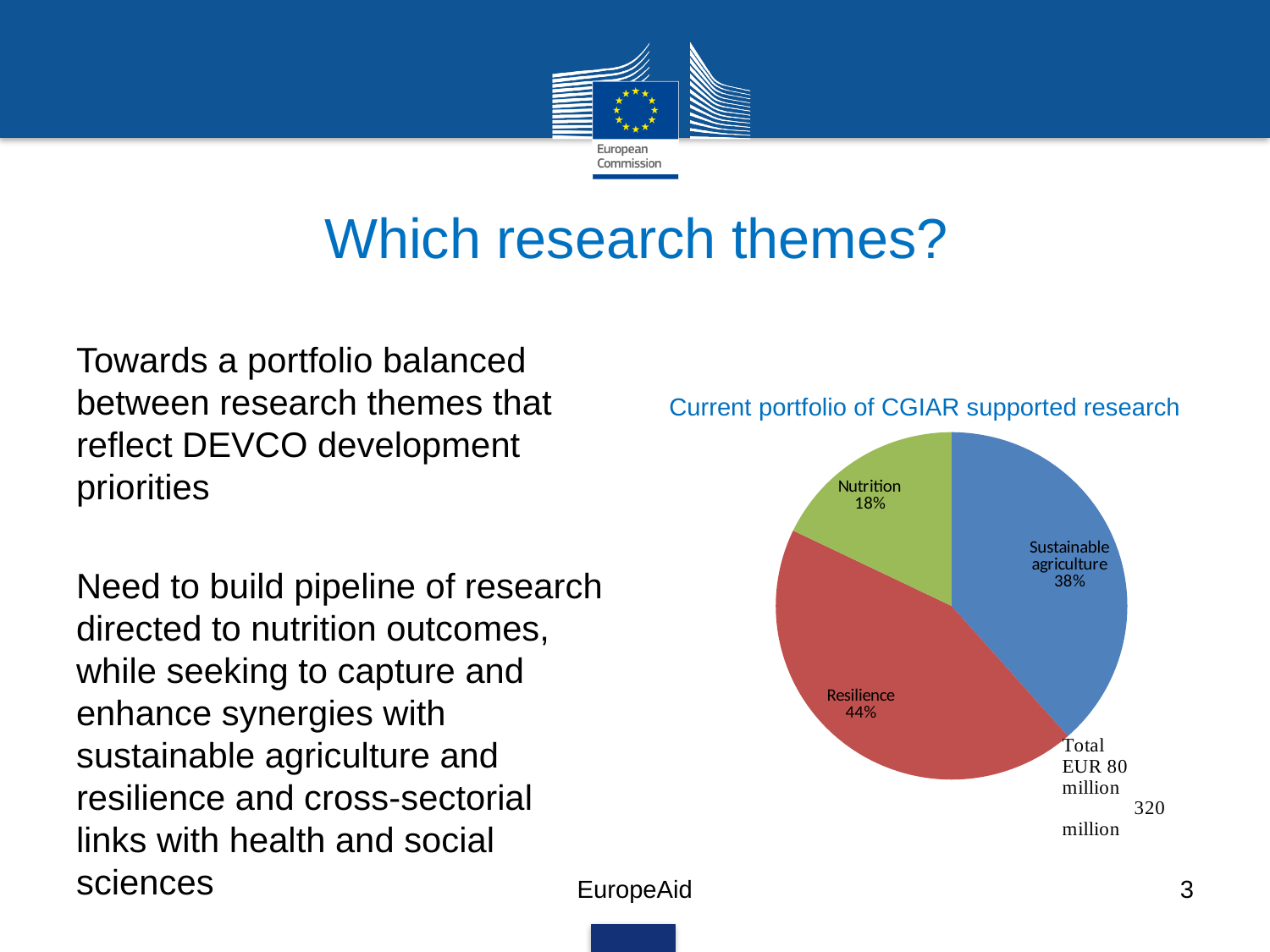
How many slices does the pie chart have? 3 What share of the pie does Nutrition have? 18% What colour is the Resilience slice? red Which has a larger share, Sustainable agriculture or Nutrition? Sustainable agriculture What share of the pie does Sustainable agriculture have? 38% What share of the pie does Resilience have? 44% What is the title of the chart? Current portfolio of CGIAR supported research What is the difference in percentage points between the Sustainable agriculture and Nutrition shares? 20 What is the difference in percentage points between the Resilience and Nutrition shares? 26 Which research theme has the smallest share of the portfolio? Nutrition What kind of chart is shown on the slide? pie chart Which research theme has the largest share of the portfolio? Resilience